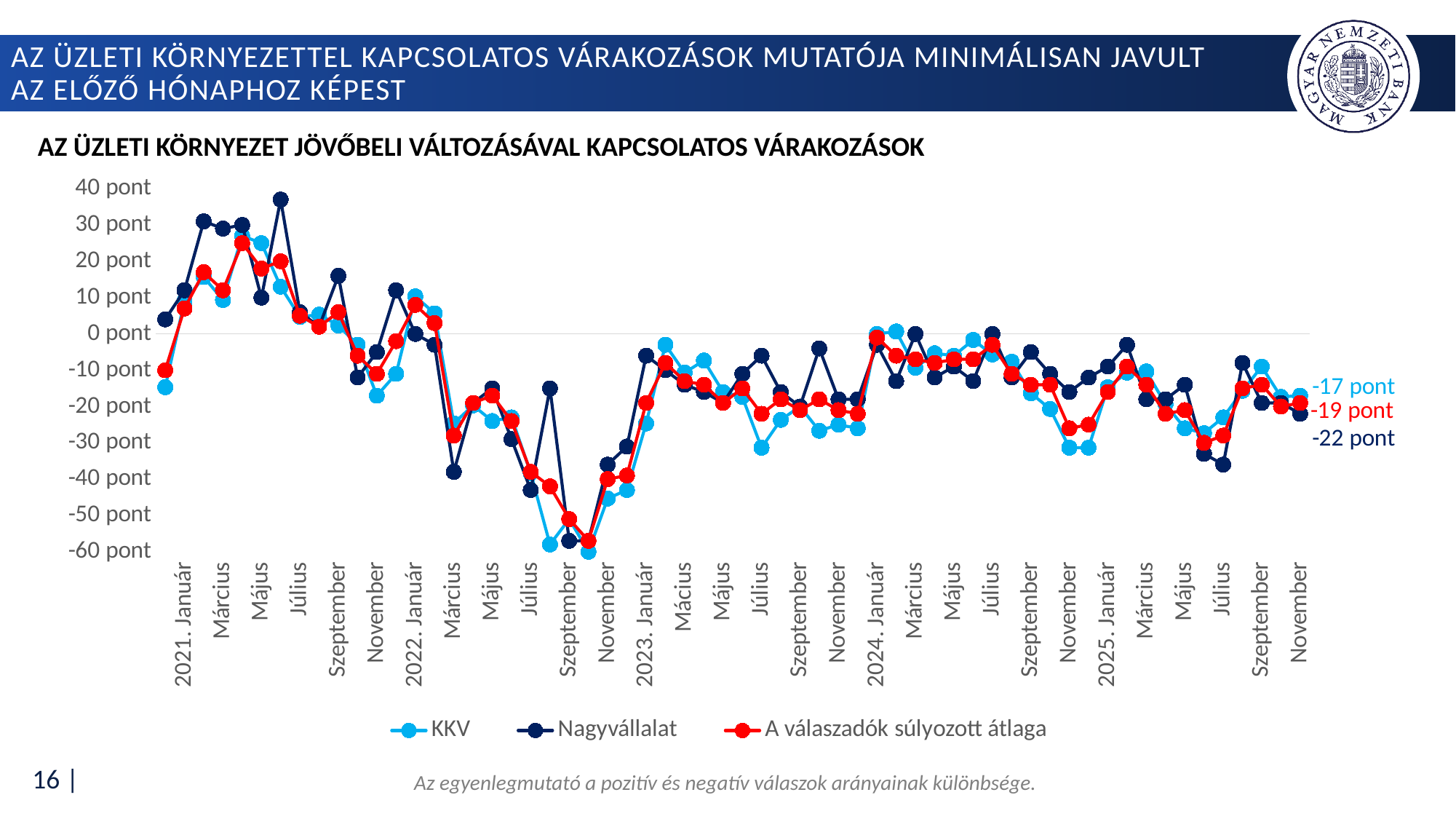
How many series does the legend list? 3 At the last point (2025 November), which is larger: the KKV value or the Nagyvállalat value? KKV Is the lowest value reached by the KKV series greater or less than -50 pont? less Which series is drawn in red? A válaszadók súlyozott átlaga Is the highest value reached by the Nagyvállalat series greater or less than 30 pont? greater What kind of chart is shown on the slide? line chart At the last point (2025 November), which series has the highest value? KKV What is the value of 'A válaszadók súlyozott átlaga' at the last point (2025 November)? -19 pont What is the difference between the KKV value (-17 pont) and the Nagyvállalat value (-22 pont) at the last point? 5 pont What is the difference between 'A válaszadók súlyozott átlaga' (-19 pont) and Nagyvállalat (-22 pont) at the last point? 3 pont What is the value of the Nagyvállalat series at the last point (2025 November)? -22 pont What is the value of the KKV series at the last point (2025 November)? -17 pont